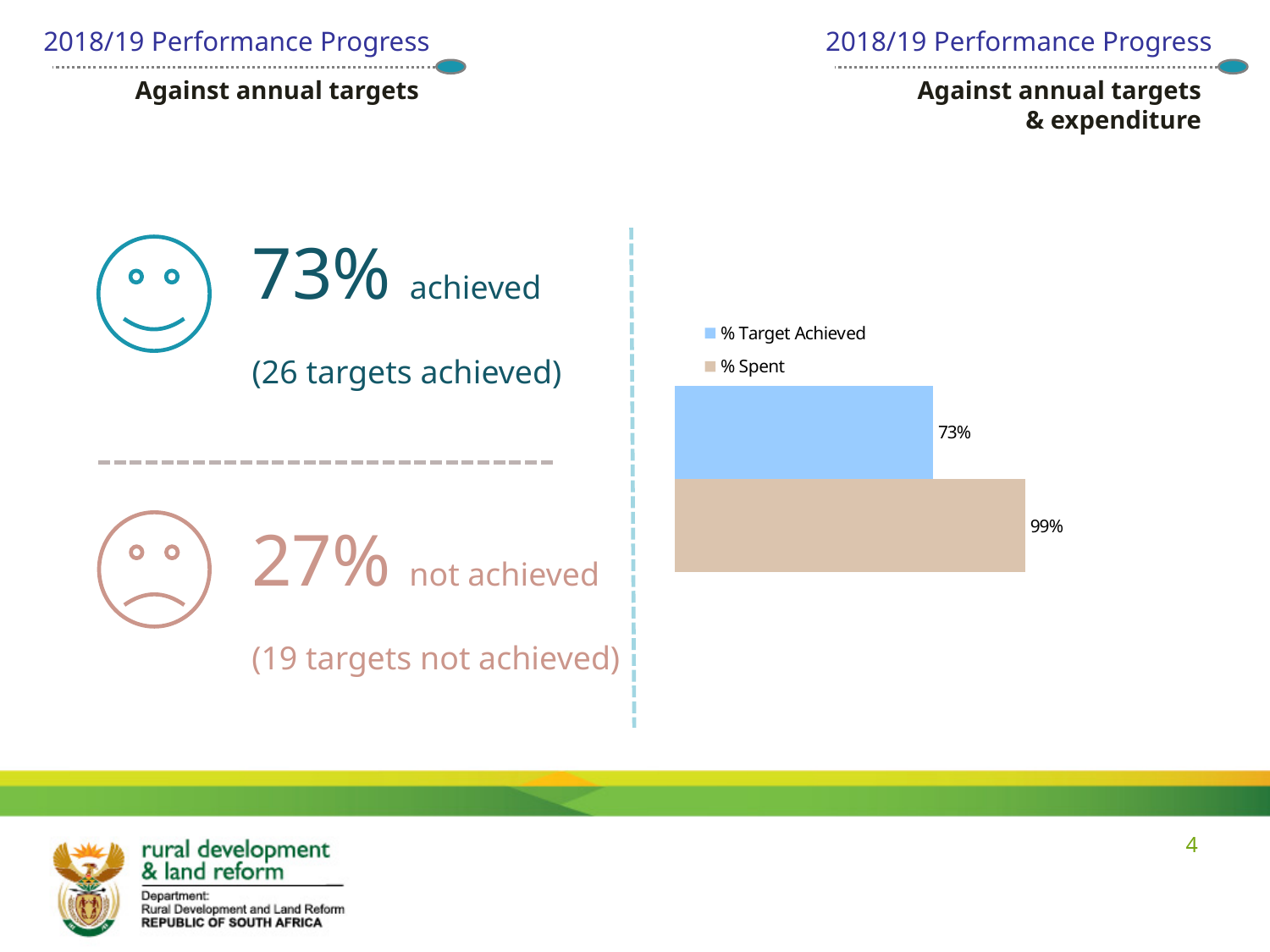
What value is shown for % Spent in the bar chart? 99% Which series has the larger value in the bar chart, % Target Achieved or % Spent? % Spent Which series has the lowest value in the bar chart? % Target Achieved What are the two legend entries of the bar chart? % Target Achieved and % Spent Which series has the highest value in the bar chart? % Spent What value is shown for % Target Achieved in the bar chart? 73% What is the difference between % Spent and % Target Achieved in the bar chart? 26% How many bars are plotted in the chart? 2 How many series does the legend of the bar chart list? 2 What kind of chart is shown on the right side of the slide? Bar chart Which legend entry in the bar chart is shown in blue? % Target Achieved